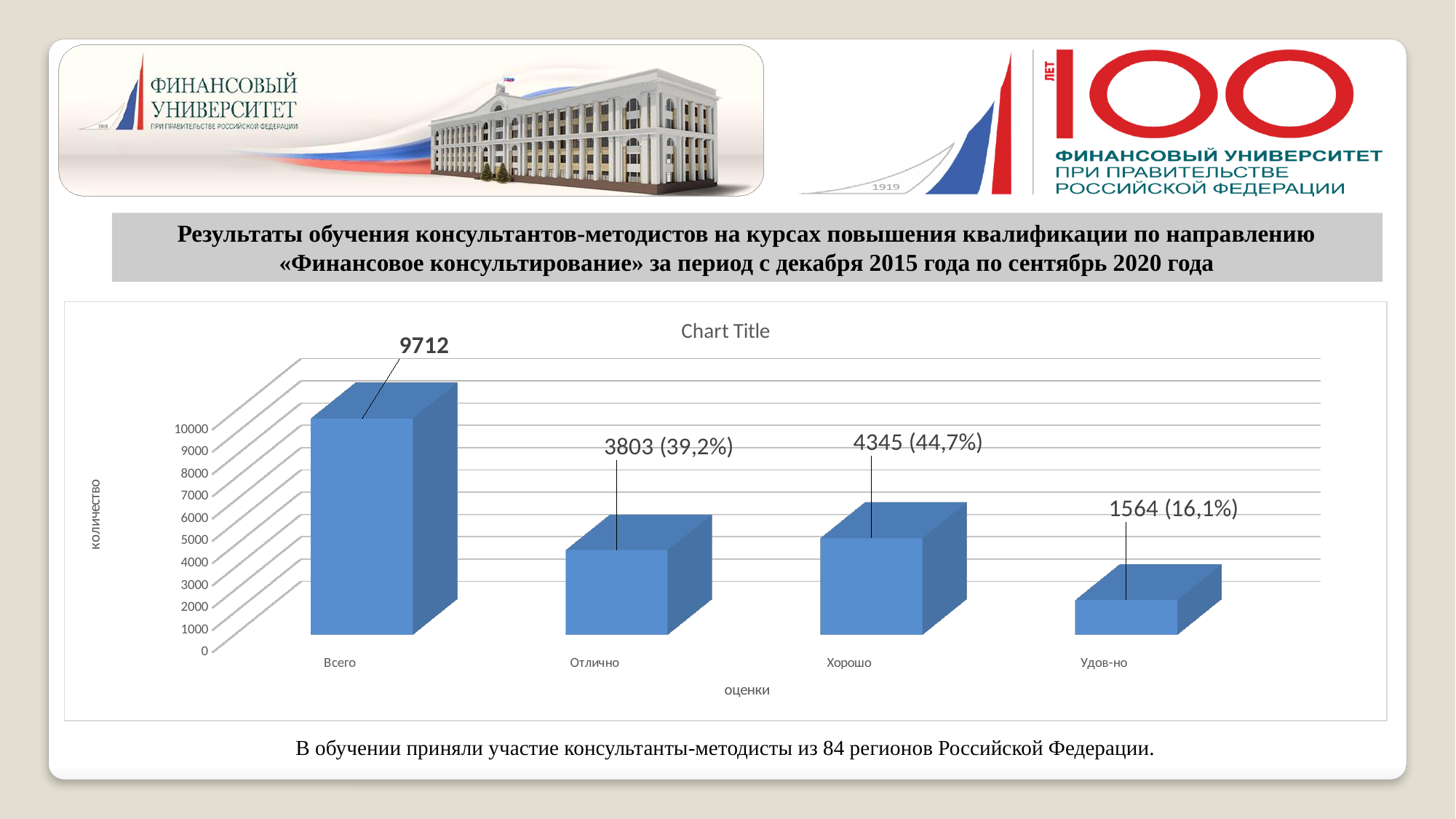
What is the label of the horizontal axis? оценки What is the value for Всего? 9712 Which category has the highest value? Всего Which category has the lowest value? Удов-но Which is larger, the value for Отлично or the value for Хорошо? Хорошо What is the data label shown for Хорошо? 4345 (44,7%) What is the data label shown for Удов-но? 1564 (16,1%) What kind of chart is shown on the slide? Bar chart What is the difference between the values for Хорошо and Отлично? 542 What is the data label shown for Отлично? 3803 (39,2%) What is the label of the vertical axis? количество How many categories are shown on the x axis? 4